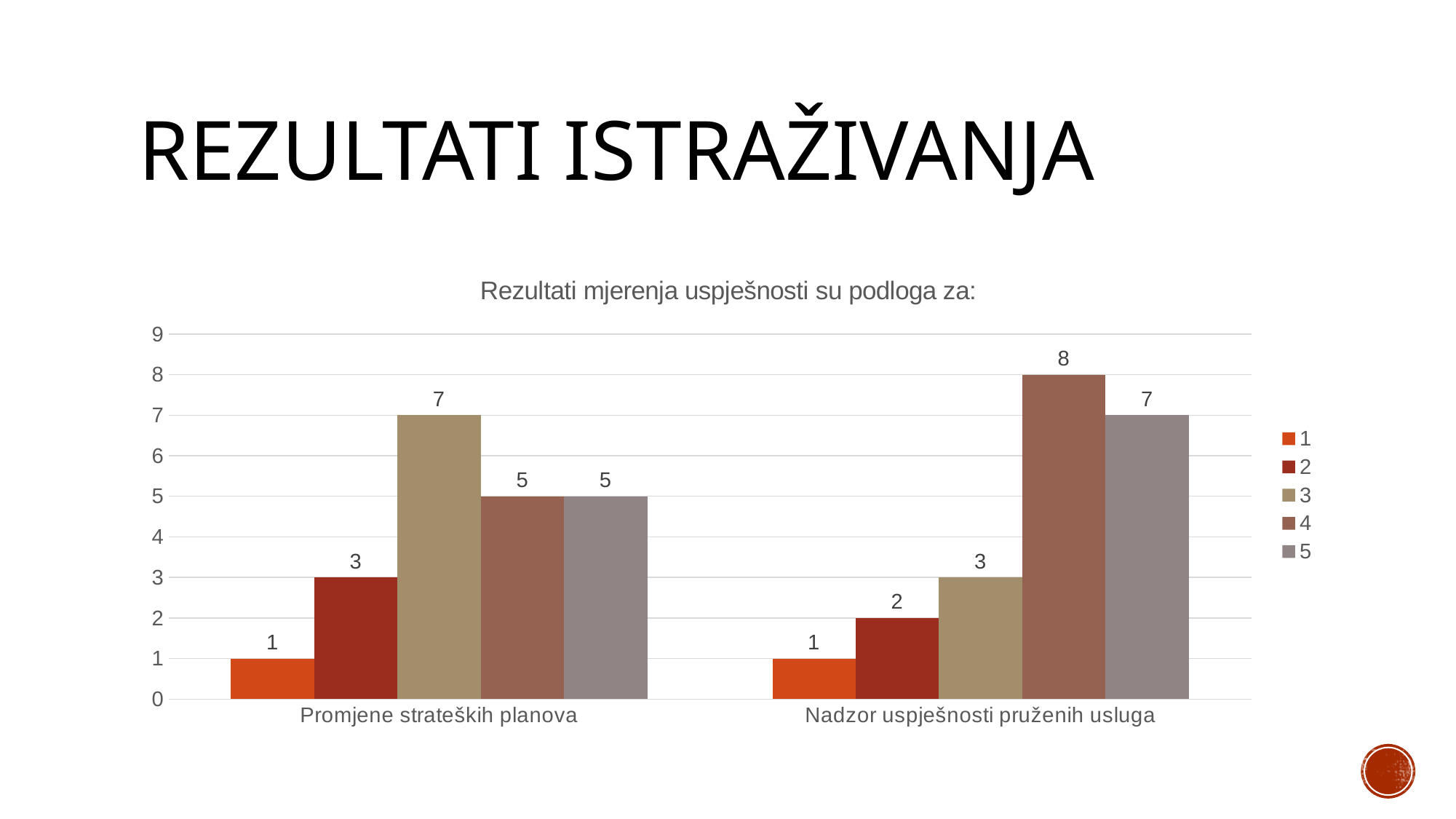
What is the value for series 2 in the 'Nadzor uspješnosti pruženih usluga' category? 2 How many categories are shown on the x axis? 2 Which is larger: the series 3 value for 'Promjene strateških planova' or the series 3 value for 'Nadzor uspješnosti pruženih usluga'? Promjene strateških planova What kind of chart is shown on the slide? Bar chart What is the title of the chart? Rezultati mjerenja uspješnosti su podloga za: How many series does the legend list? 5 Which series has the lowest value in the 'Promjene strateških planova' category? 1 Which series has the highest value in the 'Nadzor uspješnosti pruženih usluga' category? 4 What is the value for series 4 in the 'Nadzor uspješnosti pruženih usluga' category? 8 What is the difference between the series 4 value for 'Nadzor uspješnosti pruženih usluga' and the series 4 value for 'Promjene strateških planova'? 3 What is the value for series 5 in the 'Promjene strateških planova' category? 5 What is the value for series 3 in the 'Promjene strateških planova' category? 7